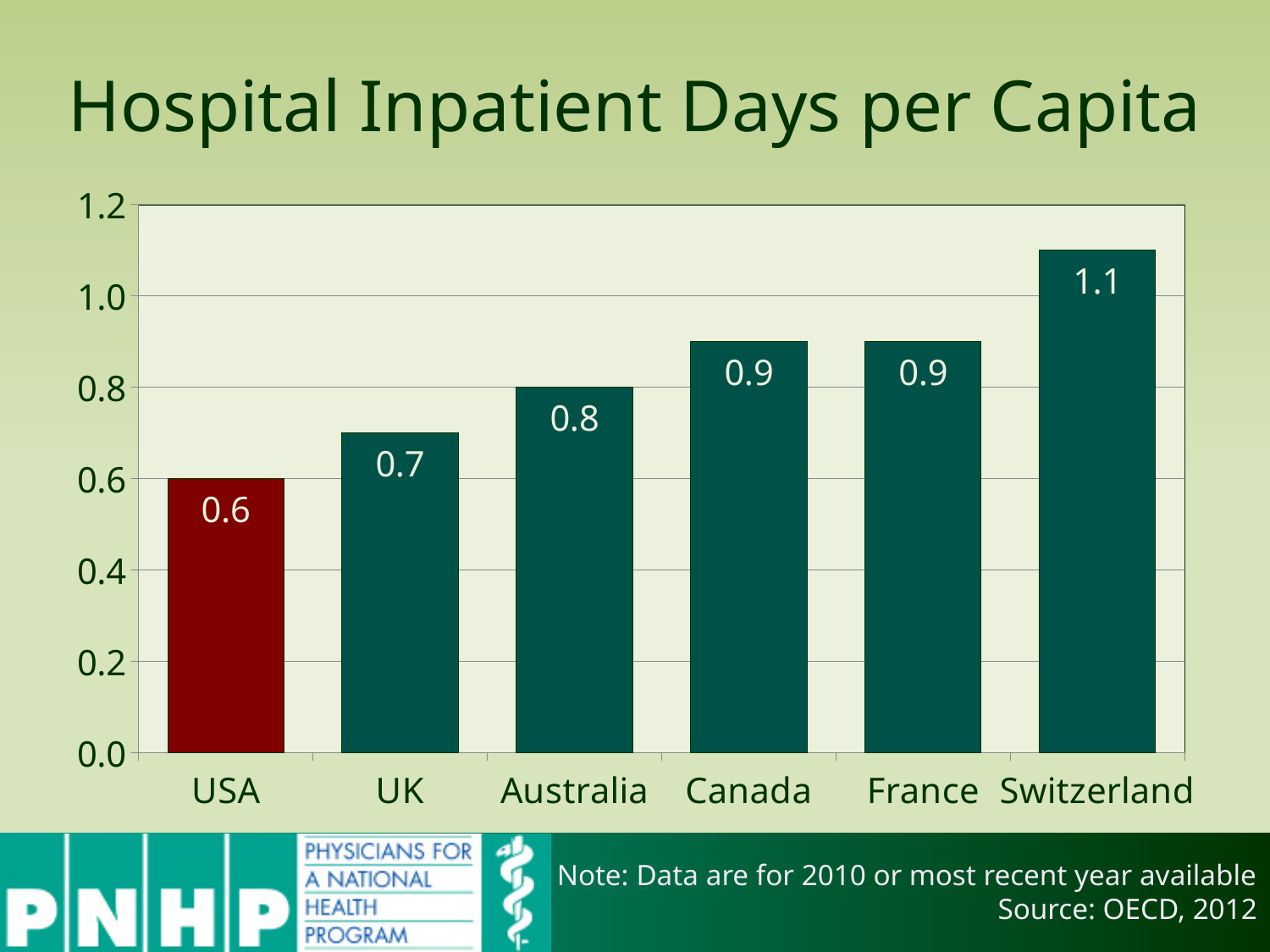
Which country has the lowest hospital inpatient days per capita? USA What kind of chart is shown on the slide? bar chart What is the difference between the values for Canada and the UK? 0.2 What is the value for the USA? 0.6 What is the title of the chart? Hospital Inpatient Days per Capita What is the difference between the values for Switzerland and the USA? 0.5 How many countries are shown in the chart? 6 What is the value for Australia? 0.8 Which country has the highest hospital inpatient days per capita? Switzerland Is the value for Switzerland greater or less than 1.0? greater What is the value for Switzerland? 1.1 Which is larger, the value for the UK or the value for France? France